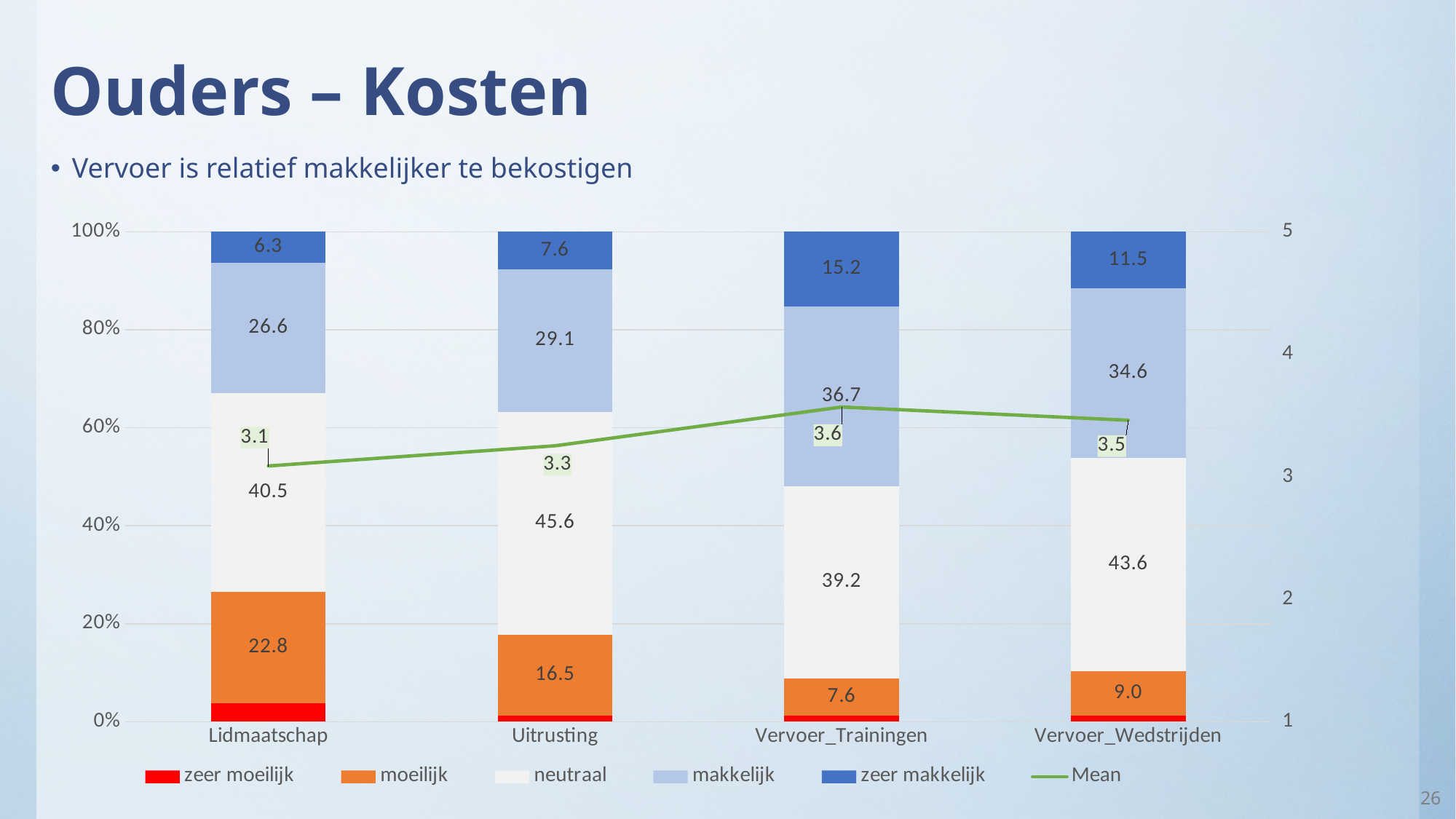
What is the 'zeer makkelijk' value for Vervoer_Wedstrijden? 11.5 What kind of chart is shown on the slide? Stacked bar chart with a line Which legend entry is shown in red? zeer moeilijk What is the difference between the 'moeilijk' values for Lidmaatschap and Uitrusting? 6.3 Which category has the highest 'zeer makkelijk' value? Vervoer_Trainingen Which category has the lowest Mean value? Lidmaatschap How many categories are shown on the x axis? 4 What is the value of the 'moeilijk' segment for Lidmaatschap? 22.8 What is the Mean value for Vervoer_Trainingen? 3.6 What is the 'neutraal' value for Uitrusting? 45.6 Which is larger: the 'makkelijk' value for Vervoer_Trainingen or for Vervoer_Wedstrijden? Vervoer_Trainingen How many series does the legend list? 6